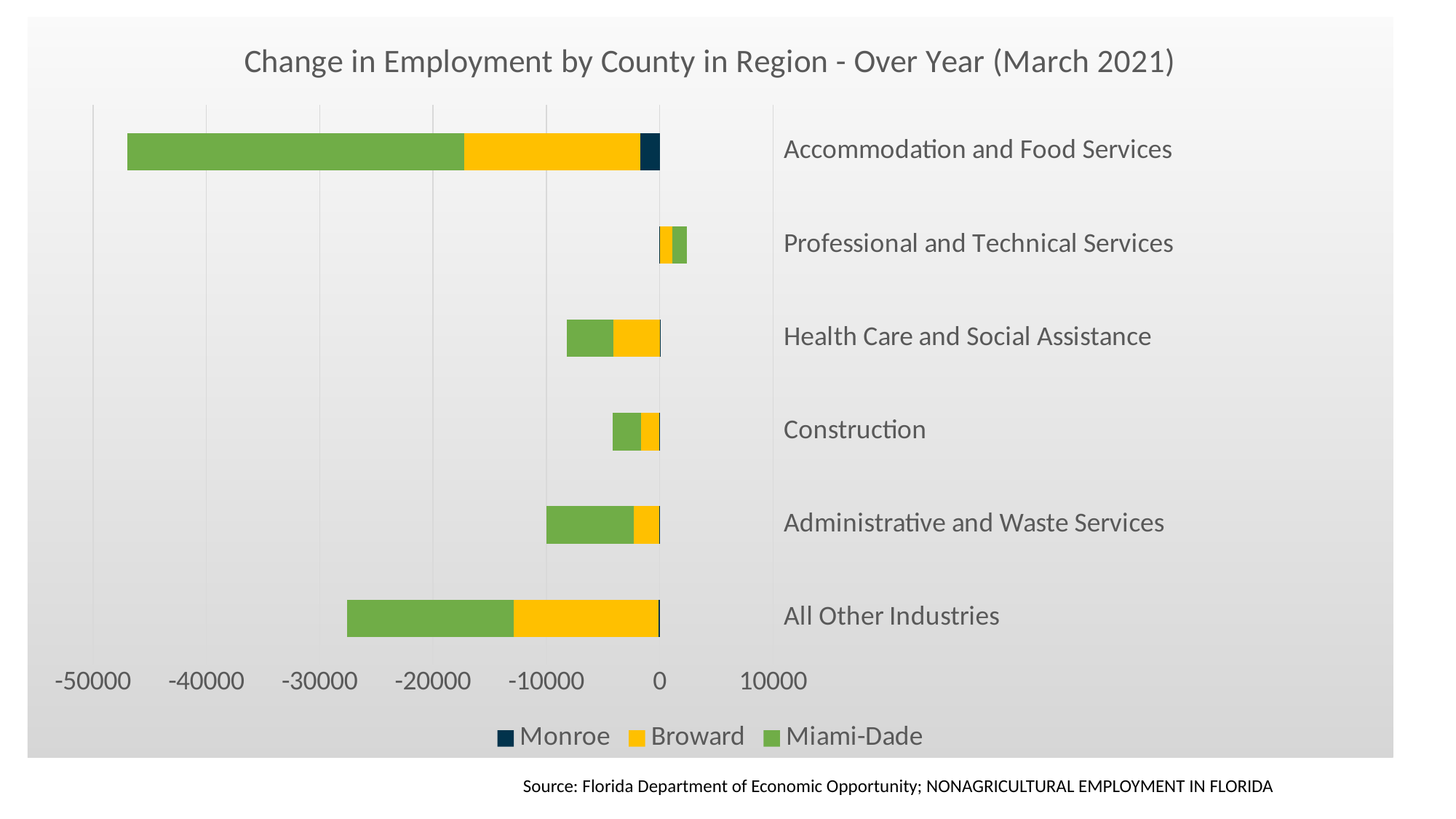
Is the total value for Health Care and Social Assistance greater or less than -10000? greater What is the title of the chart? Change in Employment by County in Region - Over Year (March 2021) Is the total value for Construction greater or less than -10000? greater What kind of chart is shown on the slide? bar chart Is the total value for All Other Industries greater or less than -20000? less How many series does the legend list? 3 Which county is represented by the green segments in the chart? Miami-Dade How many industry categories are plotted in the chart? 6 Which industry category is the only one whose bar extends to the positive side of zero? Professional and Technical Services In the Accommodation and Food Services bar, which county's segment is longer: Miami-Dade or Broward? Miami-Dade Which industry category has the longest bar (largest decline in employment)? Accommodation and Food Services